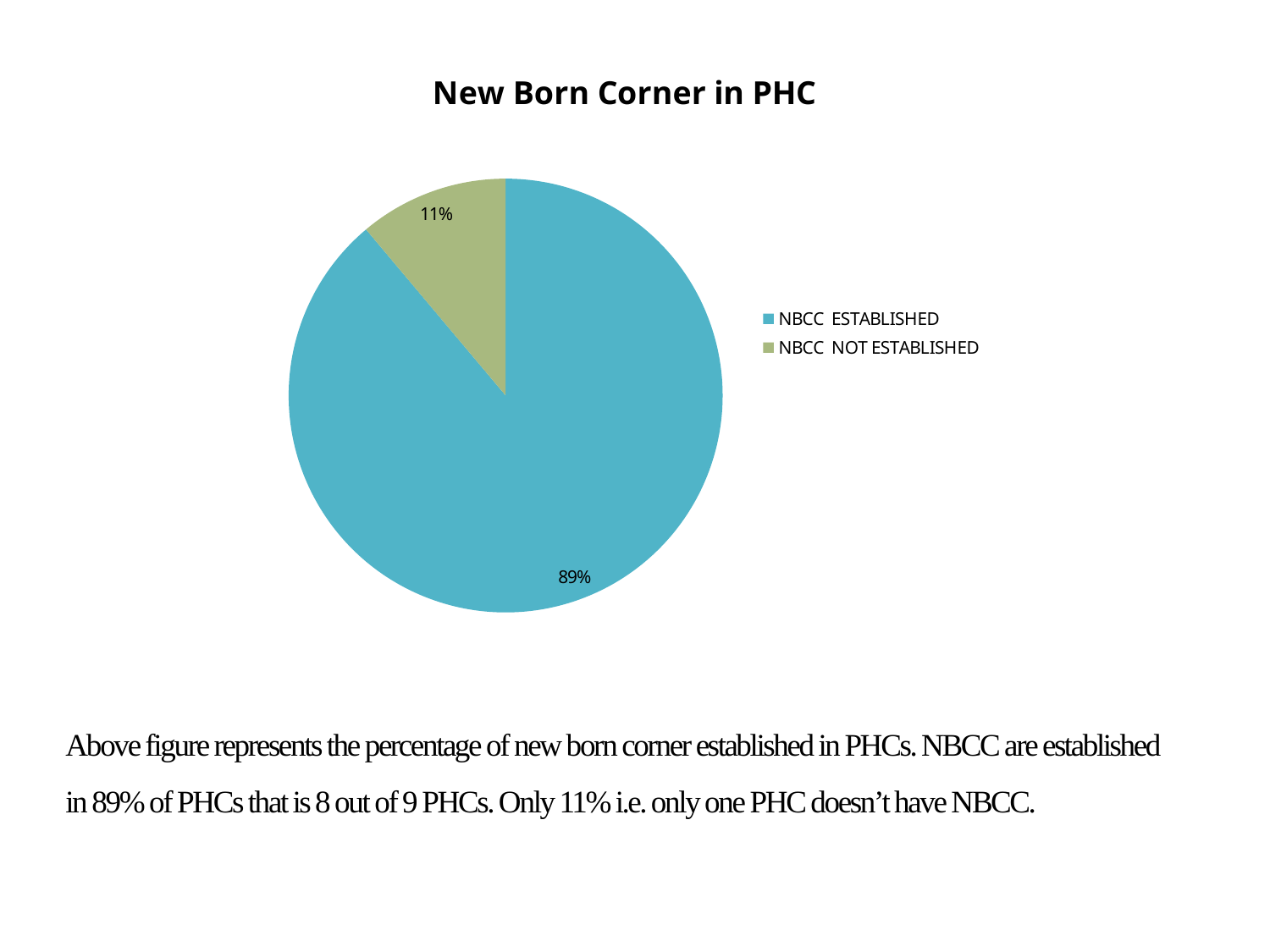
What percentage of the pie is labelled NBCC NOT ESTABLISHED? 11% What is the title of the chart? New Born Corner in PHC What type of chart is shown on the slide? pie chart How many categories does the pie chart show? 2 Which category has the largest slice of the pie? NBCC ESTABLISHED How many entries does the legend list? 2 What percentage of the pie is labelled NBCC ESTABLISHED? 89% What colour is the NBCC NOT ESTABLISHED slice? green Is the share for NBCC ESTABLISHED greater or less than 50%? greater Which category has the smallest slice of the pie? NBCC NOT ESTABLISHED Which slice is larger, NBCC ESTABLISHED or NBCC NOT ESTABLISHED? NBCC ESTABLISHED What is the difference in percentage points between the NBCC ESTABLISHED and NBCC NOT ESTABLISHED slices? 78